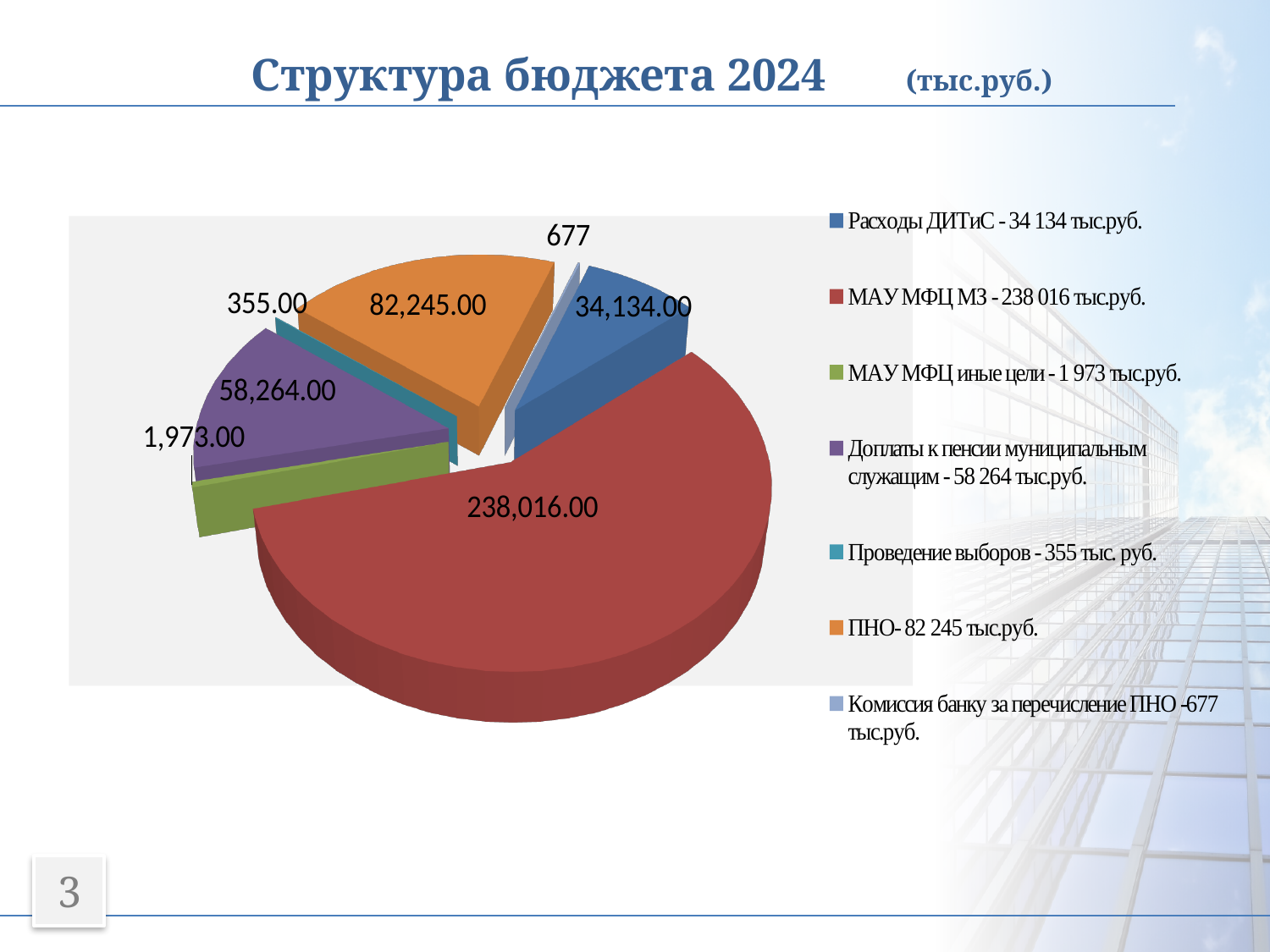
What is the value shown for Проведение выборов? 355.00 How many entries does the legend list? 7 What is the value shown for ПНО? 82,245.00 How many slices does the pie chart have? 7 What is the value shown for МАУ МФЦ МЗ? 238,016.00 What type of chart is shown on the slide? Pie chart What is the title of the slide containing the chart? Структура бюджета 2024 (тыс.руб.) What is the value shown for Комиссия банку за перечисление ПНО? 677 Which is larger: Доплаты к пенсии муниципальным служащим or Расходы ДИТиС? Доплаты к пенсии муниципальным служащим Which category has the largest slice of the pie? МАУ МФЦ МЗ Which category has the smallest slice of the pie? Проведение выборов What is the difference between the values for МАУ МФЦ МЗ and ПНО? 155,771.00